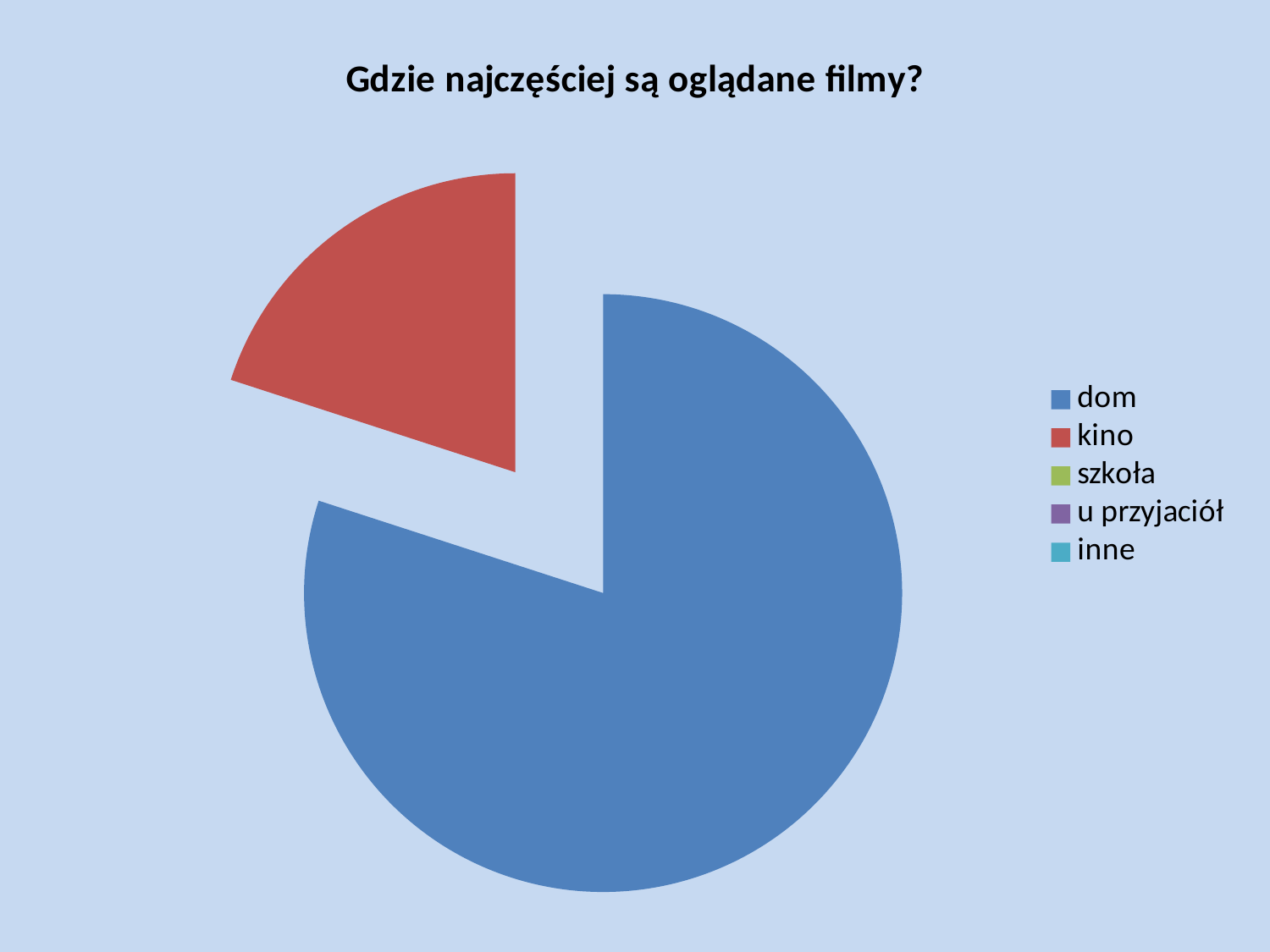
Which colour represents kino in the chart? red How many categories does the legend list? 5 Is the slice for dom more or less than half of the pie? more Which is larger, the slice for dom or the slice for kino? dom What kind of chart is shown on the slide? pie chart Which category's slice is pulled out (exploded) from the pie? kino Which category is shown in blue? dom Which category has the largest slice of the pie? dom How many slices are visible in the pie? 2